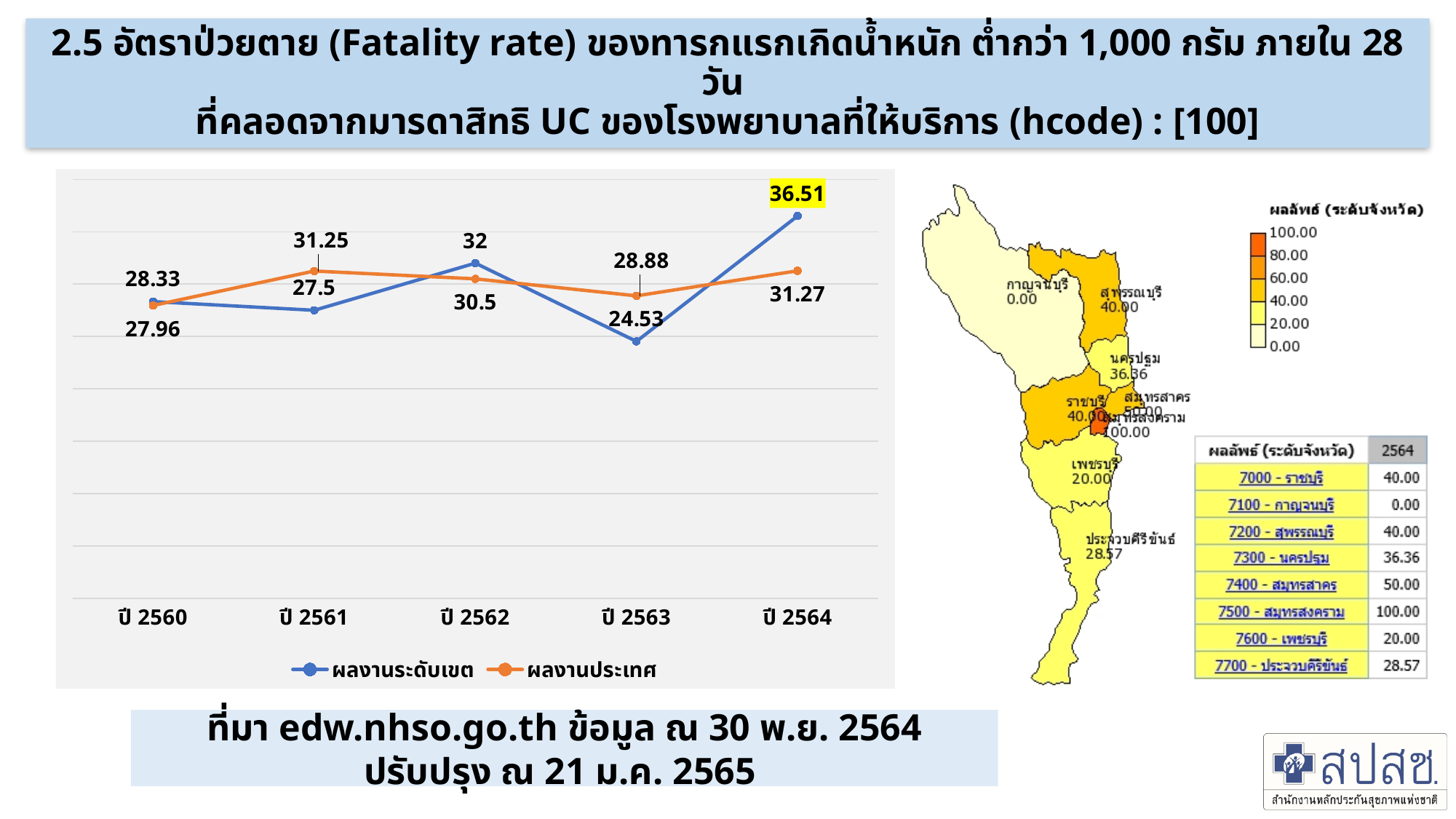
How many years are plotted along the x axis of the line chart? 5 In the line chart, what is the value of ผลงานระดับเขต for ปี 2563? 24.53 How many series does the legend of the line chart list? 2 In the line chart, what is the value of ผลงานระดับเขต for ปี 2564? 36.51 In the line chart, what is the value of ผลงานประเทศ for ปี 2561? 31.25 In the line chart, which year has the lowest value for ผลงานระดับเขต? ปี 2563 In the line chart, which series has the larger value in ปี 2563, ผลงานระดับเขต or ผลงานประเทศ? ผลงานประเทศ In the line chart, what is the value of ผลงานประเทศ for ปี 2562? 30.5 In the line chart, does ผลงานระดับเขต rise or fall from ปี 2563 to ปี 2564? rise In the line chart, which year has the highest value for ผลงานระดับเขต? ปี 2564 In the line chart, what is the difference between ผลงานระดับเขต and ผลงานประเทศ in ปี 2564? 5.24 What kind of chart is shown on the left of the slide? line chart